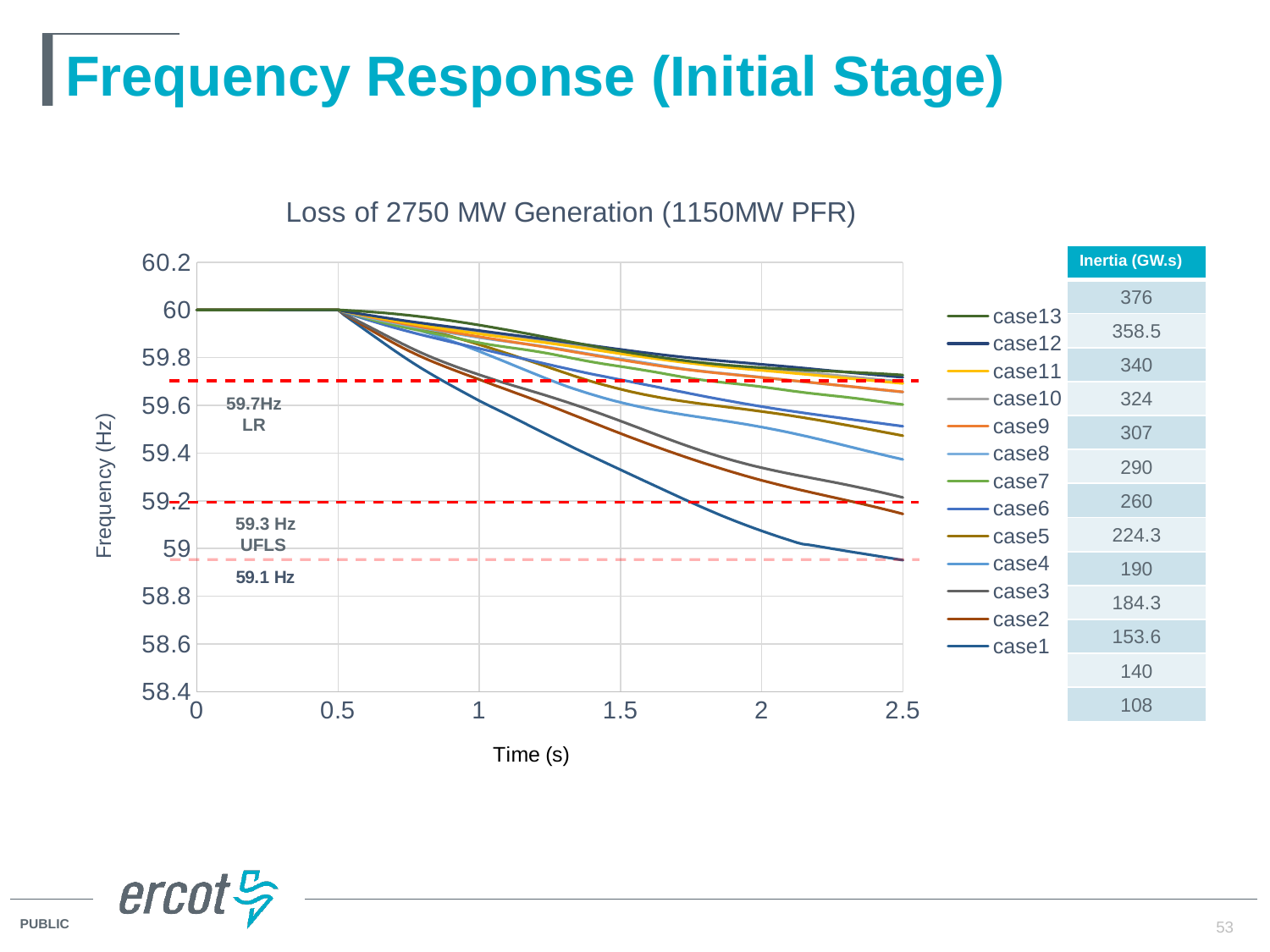
At 2.5 s, is the frequency for case1 greater or less than 59? less What is the label of the y axis? Frequency (Hz) At 2.5 s, is the frequency for case5 greater or less than 59.4? greater What kind of chart is shown on the slide? line chart At 1.5 s, which has the higher frequency, case7 or case2? case7 At 2.5 s, is the frequency for case2 greater or less than 59.2? less Do the frequency values rise or fall along the x axis after 0.5 s? fall How many series does the legend list? 13 At 2.5 s, which has the higher frequency, case13 or case1? case13 Which case has the lowest frequency at 2.5 s? case1 What is the title of the chart? Loss of 2750 MW Generation (1150MW PFR) What is the frequency value for all cases at time 0? 60